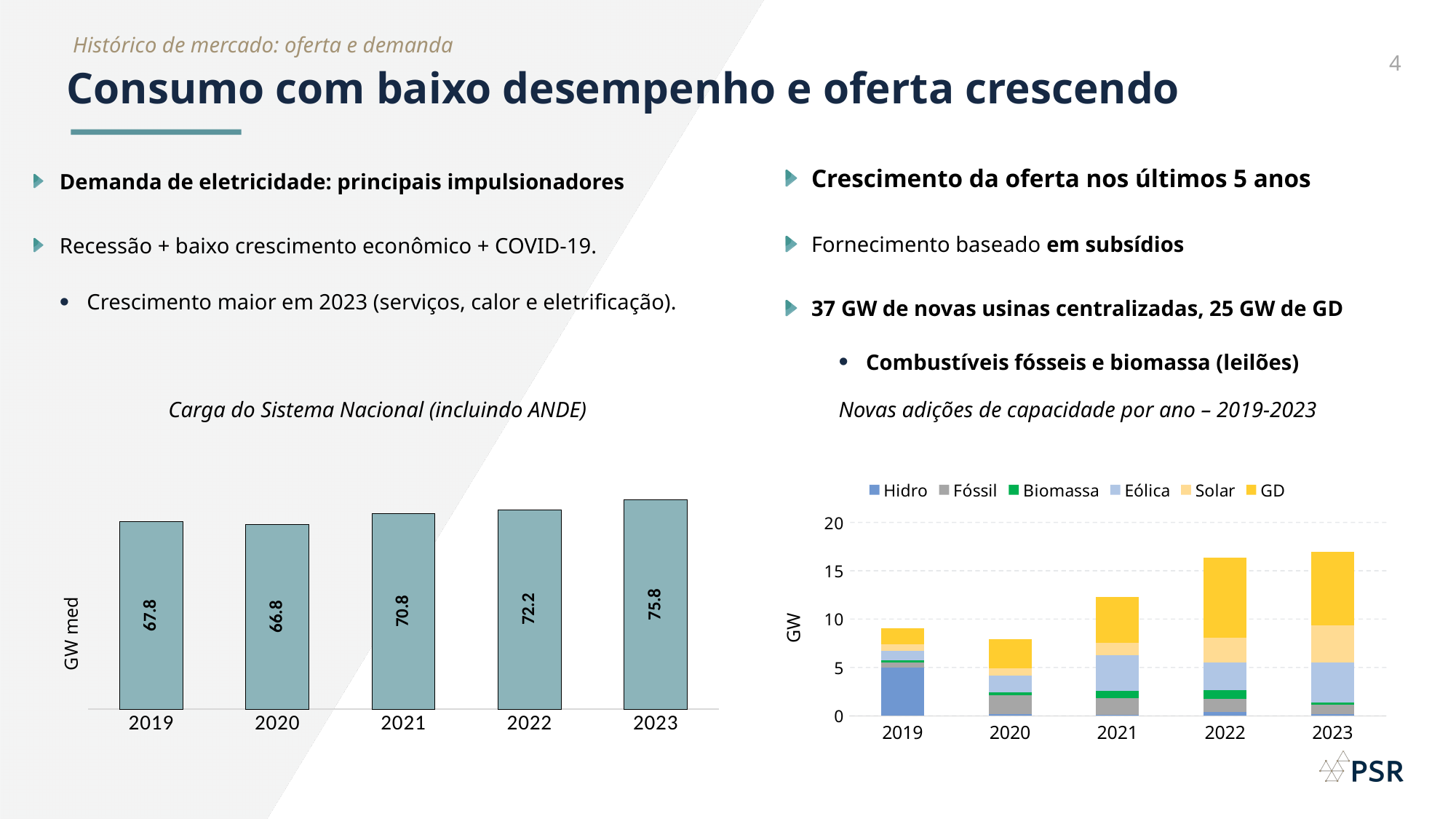
What kind of chart is the 'Carga do Sistema Nacional (incluindo ANDE)' chart? Bar chart In the 'Carga do Sistema Nacional (incluindo ANDE)' chart, what is the difference between the 2023 and 2019 values? 8.0 In the 'Carga do Sistema Nacional (incluindo ANDE)' chart, which is larger, the value for 2019 or the value for 2020? 2019 In the 'Novas adições de capacidade por ano – 2019-2023' chart, is the total for 2022 greater or less than 15? greater In the 'Novas adições de capacidade por ano – 2019-2023' chart, is the total for 2020 greater or less than 10? less In the 'Carga do Sistema Nacional (incluindo ANDE)' chart, which year has the highest value? 2023 How many years are shown in the 'Carga do Sistema Nacional (incluindo ANDE)' chart? 5 What is the unit shown on the y axis of the 'Novas adições de capacidade por ano – 2019-2023' chart? GW In the 'Carga do Sistema Nacional (incluindo ANDE)' chart, which year has the lowest value? 2020 In the 'Carga do Sistema Nacional (incluindo ANDE)' chart, what is the value for 2023? 75.8 How many series does the legend of the 'Novas adições de capacidade por ano – 2019-2023' chart list? 6 In the 'Carga do Sistema Nacional (incluindo ANDE)' chart, what is the value for 2021? 70.8